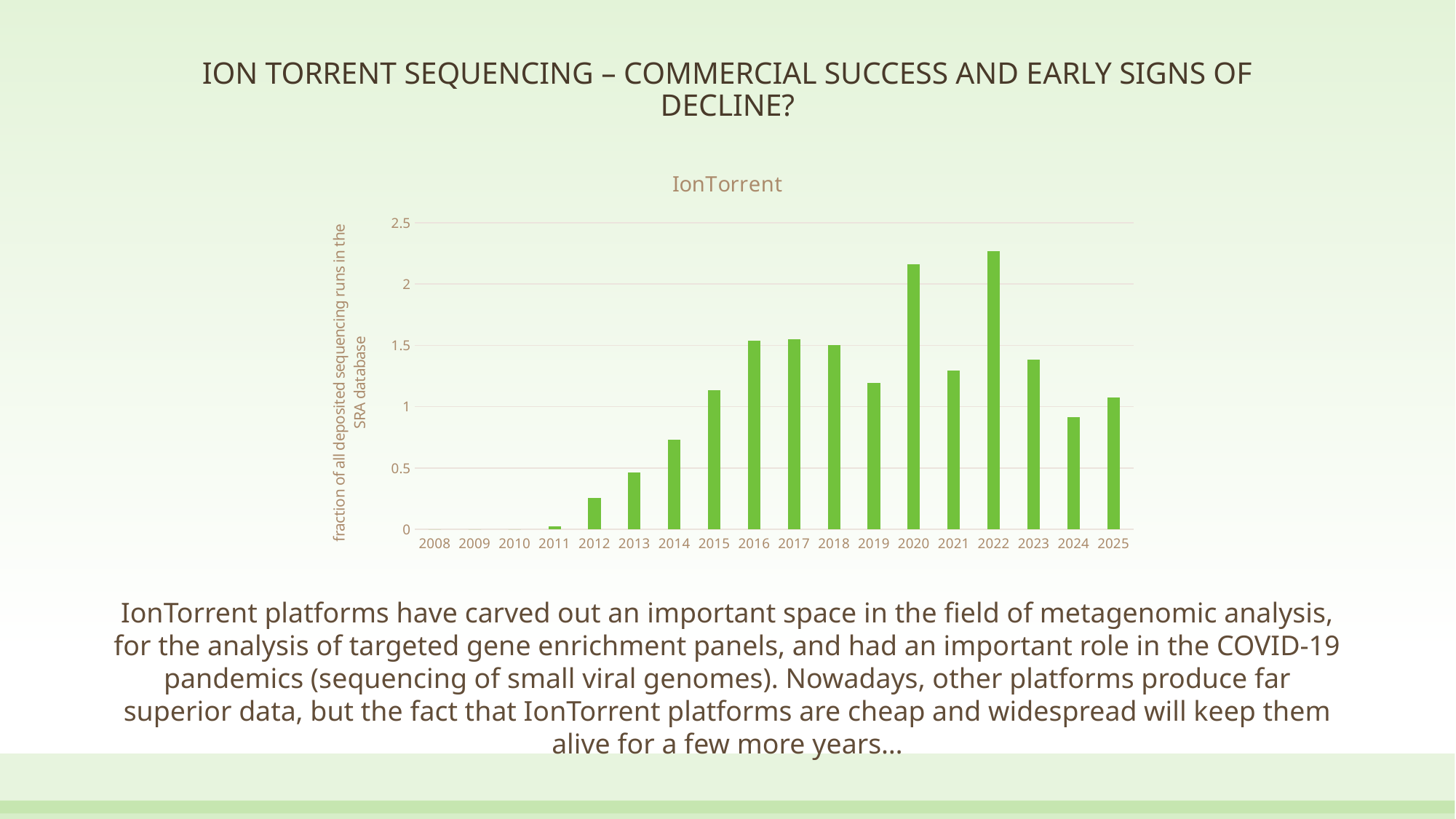
Which year has the highest bar in the chart? 2022 Which is larger, the value for 2020 or the value for 2021? 2020 Which is larger, the value for 2023 or the value for 2024? 2023 Is the value for 2014 greater or less than 0.5? greater Do the values rise or fall from 2012 to 2017? rise Is the value for 2024 greater or less than 1? less Is the value for 2012 greater or less than 0.5? less What is the title of the chart? IonTorrent How many years are shown on the x axis of the chart? 18 What is the label of the y axis? fraction of all deposited sequencing runs in the SRA database What kind of chart is shown on the slide? bar chart